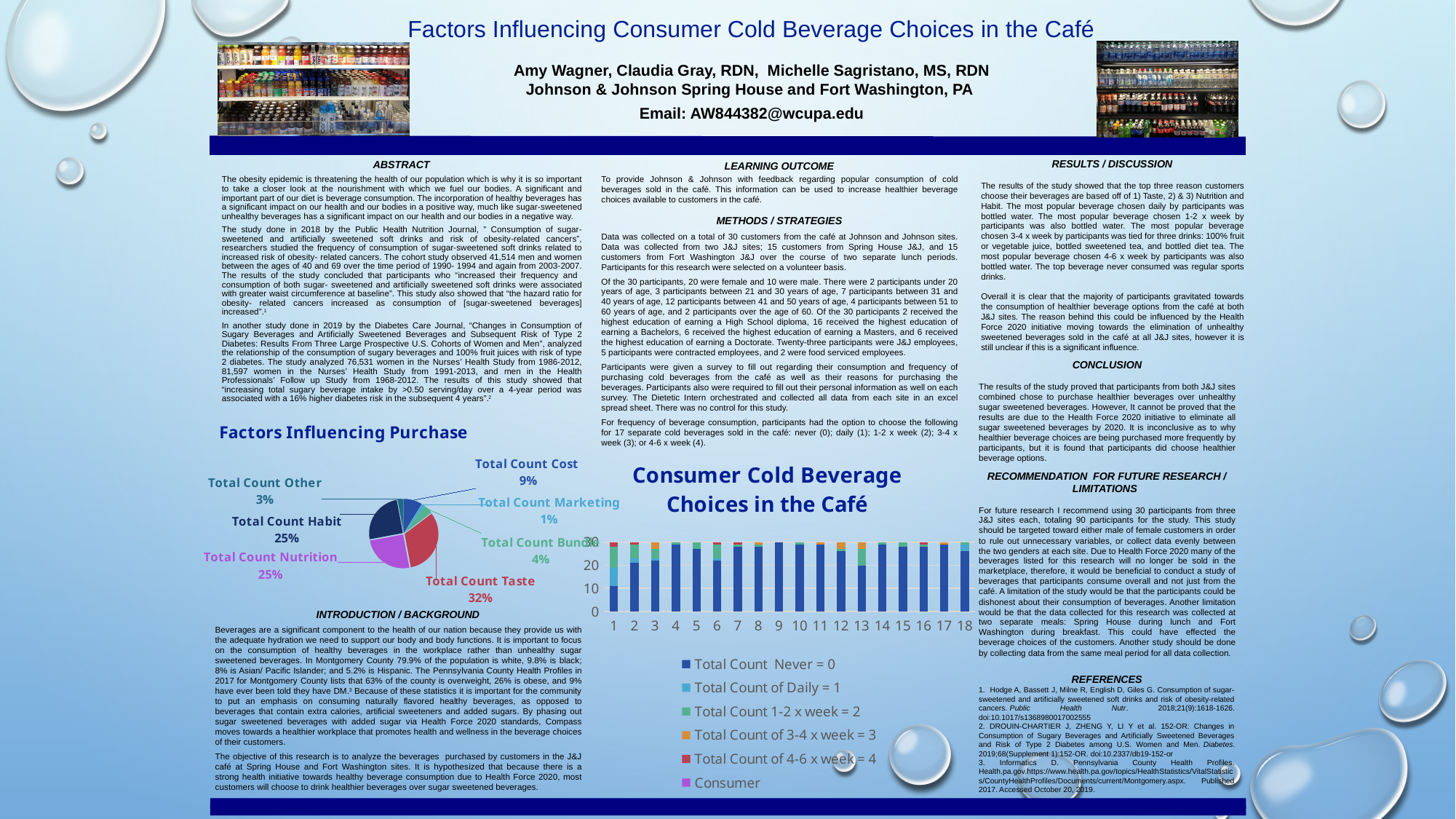
In the Factors Influencing Purchase pie chart, which slice has the smallest share? Total Count Marketing In the Factors Influencing Purchase pie chart, which is larger: Total Count Cost or Total Count Bundle? Total Count Cost In the Factors Influencing Purchase pie chart, how many slices are there? 7 What kind of chart is the Factors Influencing Purchase chart? Pie chart In the Factors Influencing Purchase pie chart, what is the difference in percentage points between Total Count Taste and Total Count Cost? 23 In the Factors Influencing Purchase pie chart, what percentage is shown for Total Count Habit? 25% In the Factors Influencing Purchase pie chart, what percentage is shown for Total Count Taste? 32% In the Factors Influencing Purchase pie chart, which slice has the largest share? Total Count Taste In the Consumer Cold Beverage Choices in the Café chart, is the total height of bar 1 greater or less than 20? greater In the Consumer Cold Beverage Choices in the Café chart, how many bars are plotted along the x axis? 18 In the Consumer Cold Beverage Choices in the Café chart, how many entries does the legend list? 6 What kind of chart is the Consumer Cold Beverage Choices in the Café chart? Bar chart